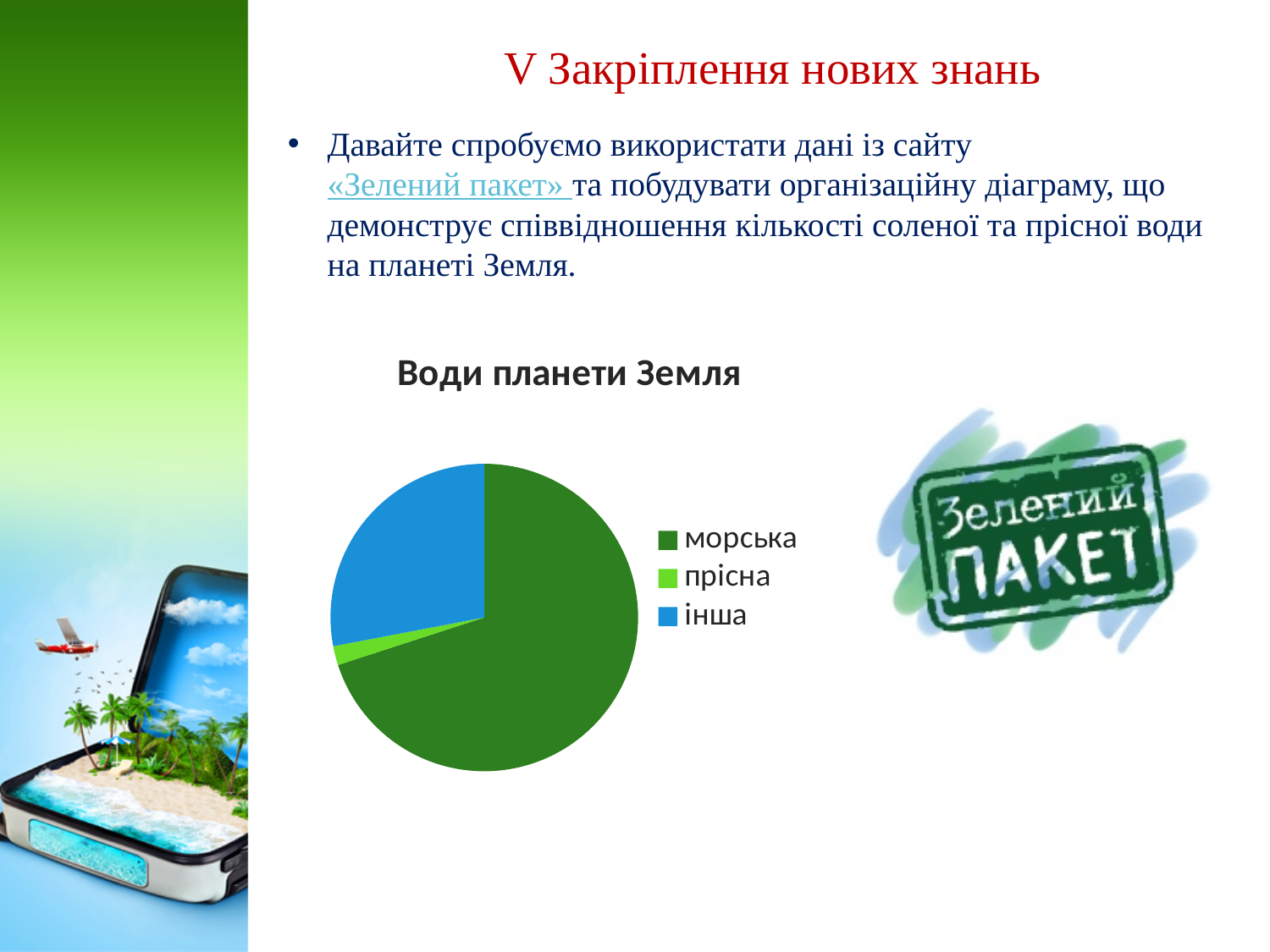
Which slice is larger, морська or прісна? морська Which slice is larger, прісна or інша? інша What is the title of the chart? Води планети Земля How many slices does the pie chart have? 3 What colour is the slice for інша? blue How many entries does the chart legend list? 3 Which category has the smallest slice of the pie? прісна Which category has the largest slice of the pie? морська Which legend entry is listed first? морська What kind of chart is shown on the slide? pie chart Which slice is larger, морська or інша? морська